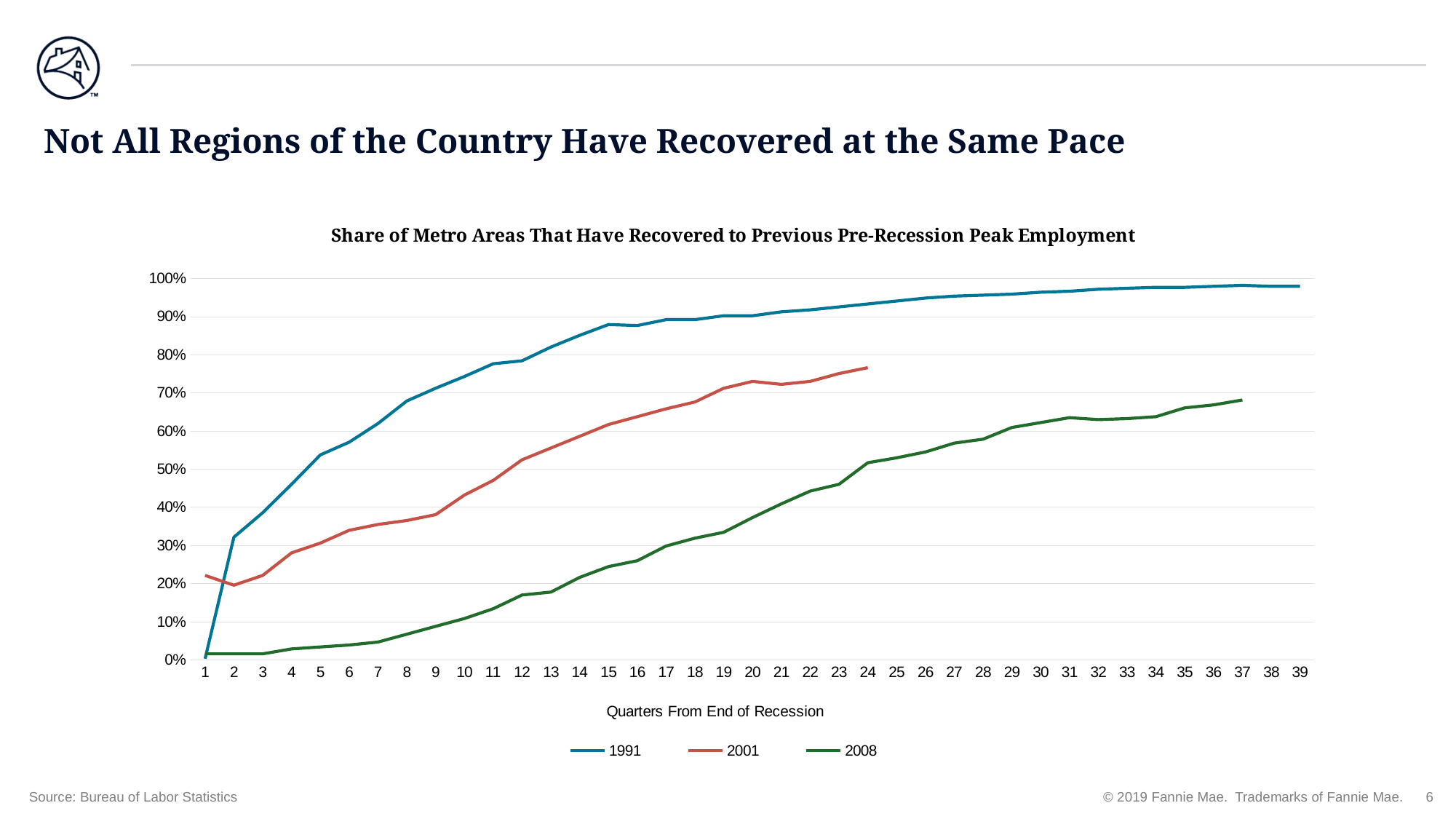
What kind of chart is shown on the slide? line chart How many series does the legend list? 3 Is the value for the 2001 series at quarter 24 greater or less than 70%? greater What is the label of the x axis? Quarters From End of Recession Is the value for the 1991 series at quarter 15 greater or less than 80%? greater At quarter 24, which series has the larger value, 2001 or 2008? 2001 Does the 2008 series generally rise or fall as the quarters increase? rise How many quarters are labelled along the x axis? 39 Which series has the lowest value at quarter 15? 2008 At quarter 10, which series has the larger value, 1991 or 2001? 1991 Is the value for the 2008 series at quarter 12 greater or less than 20%? less